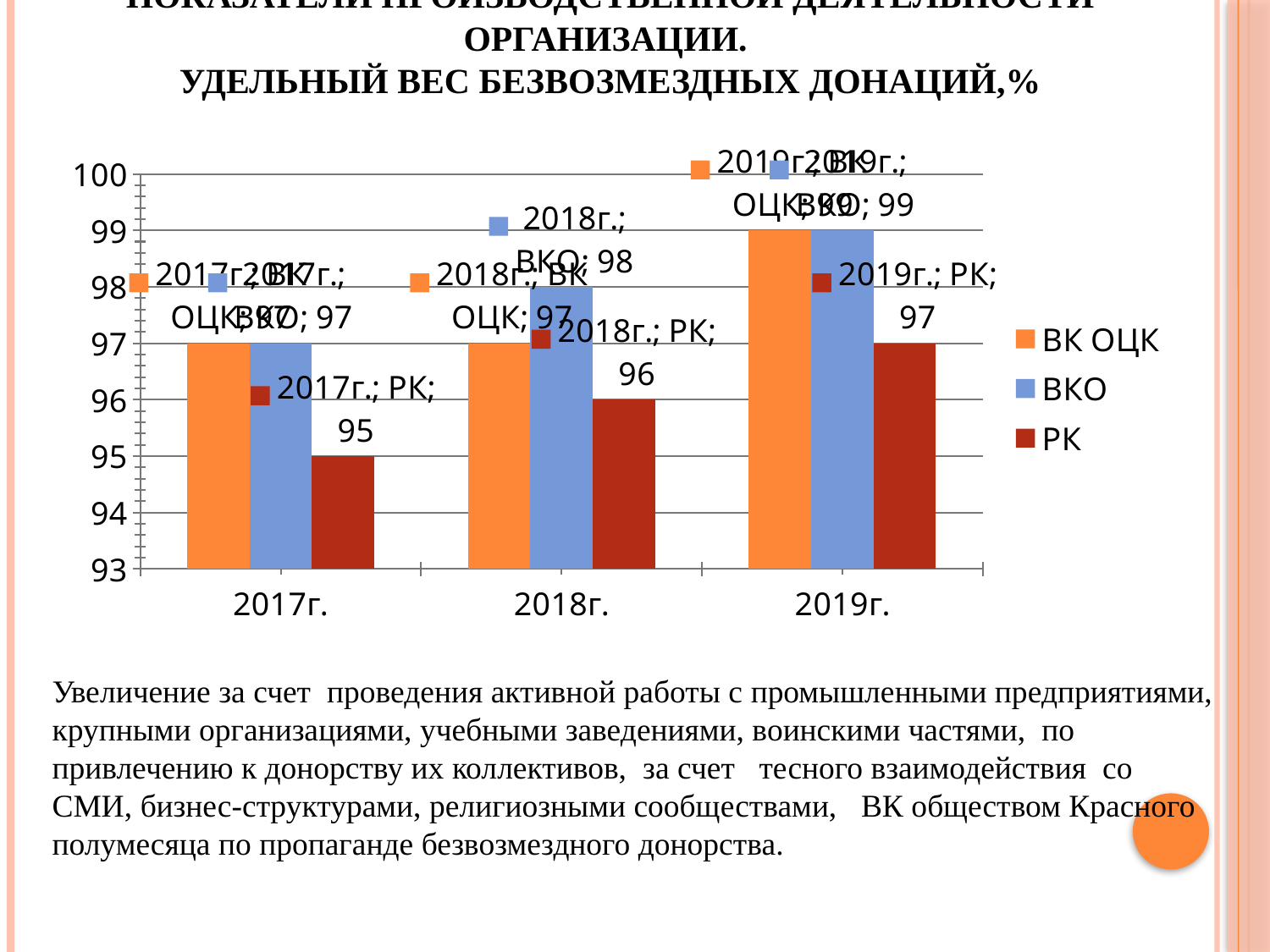
How many year categories are shown on the x axis? 3 Which is larger in 2018г., the ВКО value or the РК value? ВКО What is the value for ВК ОЦК in 2019г.? 99 In which year is the РК value lowest? 2017г. What is the value for РК in 2017г.? 95 In which year is the ВКО value highest? 2019г. What is the difference between the РК values for 2019г. and 2017г.? 2 How many series does the legend list? 3 Do the РК values rise or fall from 2017г. to 2019г.? rise What is the value for ВКО in 2018г.? 98 What kind of chart is shown on the slide? bar chart What is the value for РК in 2019г.? 97